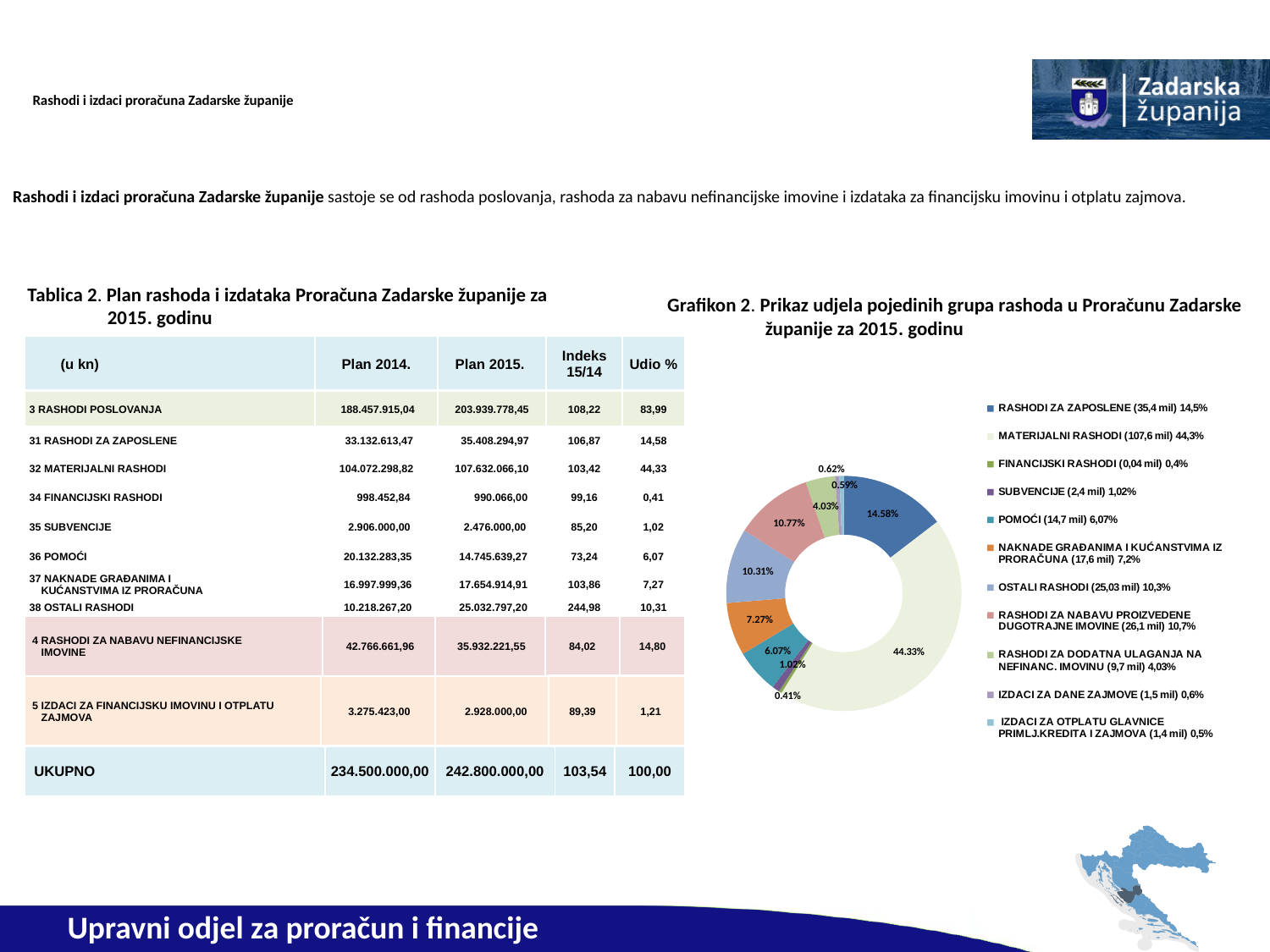
In Grafikon 2, what share is shown for SUBVENCIJE? 1.02% In Grafikon 2, which group of expenditures has the largest share? MATERIJALNI RASHODI In Grafikon 2, which has the larger share: OSTALI RASHODI or RASHODI ZA NABAVU PROIZVEDENE DUGOTRAJNE IMOVINE? RASHODI ZA NABAVU PROIZVEDENE DUGOTRAJNE IMOVINE What is the title of the chart on the right side of the slide? Grafikon 2. Prikaz udjela pojedinih grupa rashoda u Proračunu Zadarske županije za 2015. godinu How many slices does the chart in Grafikon 2 have? 11 In Grafikon 2, what is the difference in percentage points between the shares of MATERIJALNI RASHODI and RASHODI ZA ZAPOSLENE? 29.75 percentage points In Grafikon 2, what share is shown for MATERIJALNI RASHODI? 44.33% In Grafikon 2, which group of expenditures has the smallest share? FINANCIJSKI RASHODI In Grafikon 2, what share is shown for POMOĆI? 6.07% In Grafikon 2, what share is shown for RASHODI ZA ZAPOSLENE? 14.58% What kind of chart is Grafikon 2? Pie (doughnut) chart How many entries does the legend of Grafikon 2 list? 11